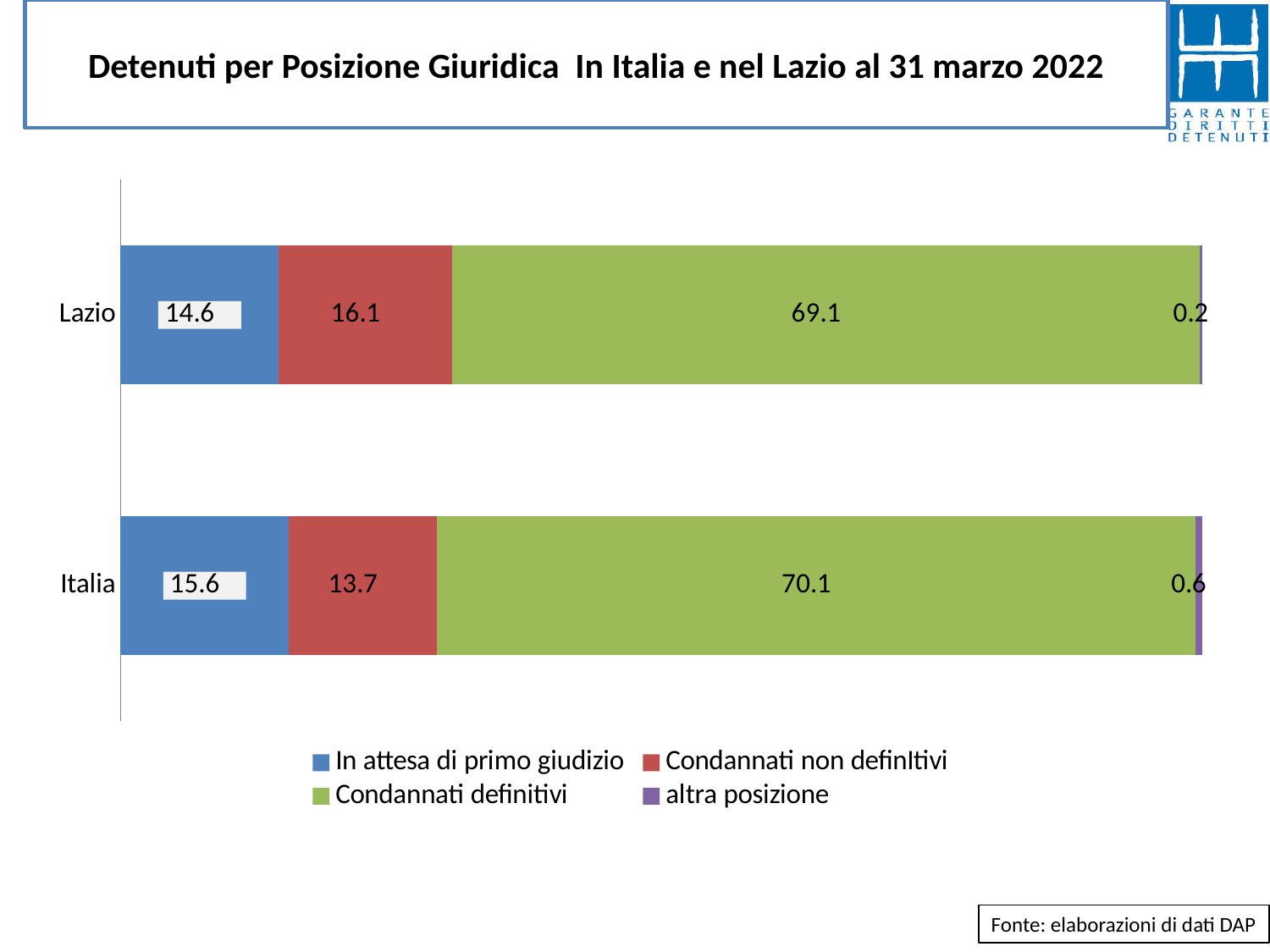
What is the value for 'In attesa di primo giudizio' for Lazio? 14.6 What is the value for 'Condannati definitivi' for Italia? 70.1 What is the value for 'altra posizione' for Italia? 0.6 Which is larger, the 'In attesa di primo giudizio' value for Italia or for Lazio? Italia How many categories are shown on the chart? 2 How many series does the legend list? 4 Which series has the lowest value for Italia? altra posizione What is the value for 'Condannati non definitivi' for Lazio? 16.1 What is the total of the stacked bar for Lazio? 100 What is the difference between the 'Condannati non definitivi' values for Lazio and Italia? 2.4 Which series has the highest value for Lazio? Condannati definitivi What kind of chart is shown on the slide? Stacked bar chart